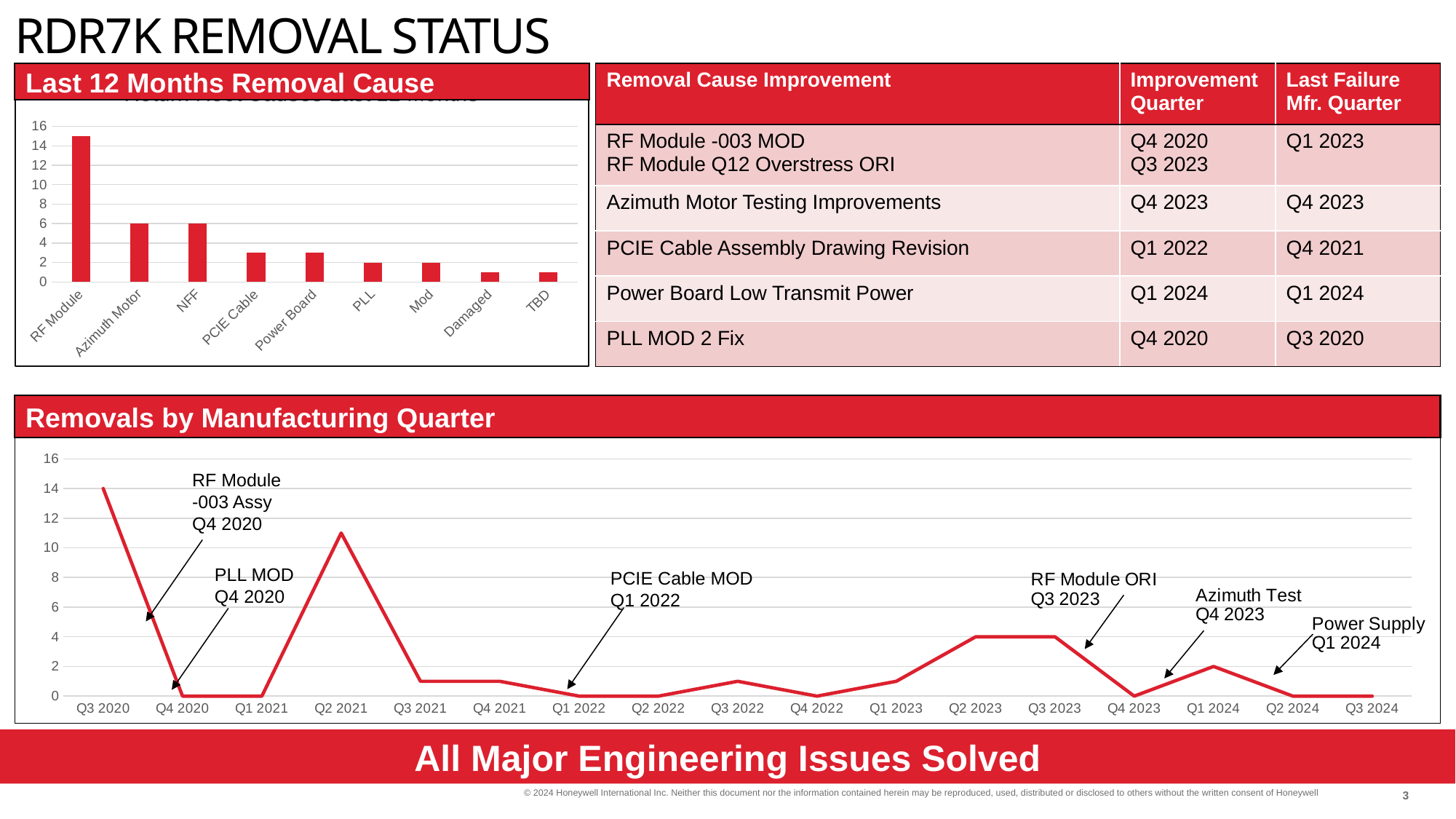
In the 'Removals by Manufacturing Quarter' chart, what is the value for Q3 2020? 14 What kind of chart is the 'Removals by Manufacturing Quarter' chart? line chart In the 'Removals by Manufacturing Quarter' chart, what is the difference between the values for Q3 2020 and Q2 2023? 10 In the 'Last 12 Months Removal Cause' chart, is the value for RF Module greater or less than 10? greater How many removal cause categories are shown in the 'Last 12 Months Removal Cause' chart? 9 In the 'Last 12 Months Removal Cause' chart, what is the value for Azimuth Motor? 6 In the 'Removals by Manufacturing Quarter' chart, is the value for Q2 2021 greater or less than 10? greater In the 'Last 12 Months Removal Cause' chart, which is larger, NFF or PLL? NFF What kind of chart is the 'Last 12 Months Removal Cause' chart? bar chart In the 'Removals by Manufacturing Quarter' chart, what is the value for Q2 2023? 4 In the 'Removals by Manufacturing Quarter' chart, which quarter has the highest number of removals? Q3 2020 In the 'Last 12 Months Removal Cause' chart, which removal cause has the highest count? RF Module